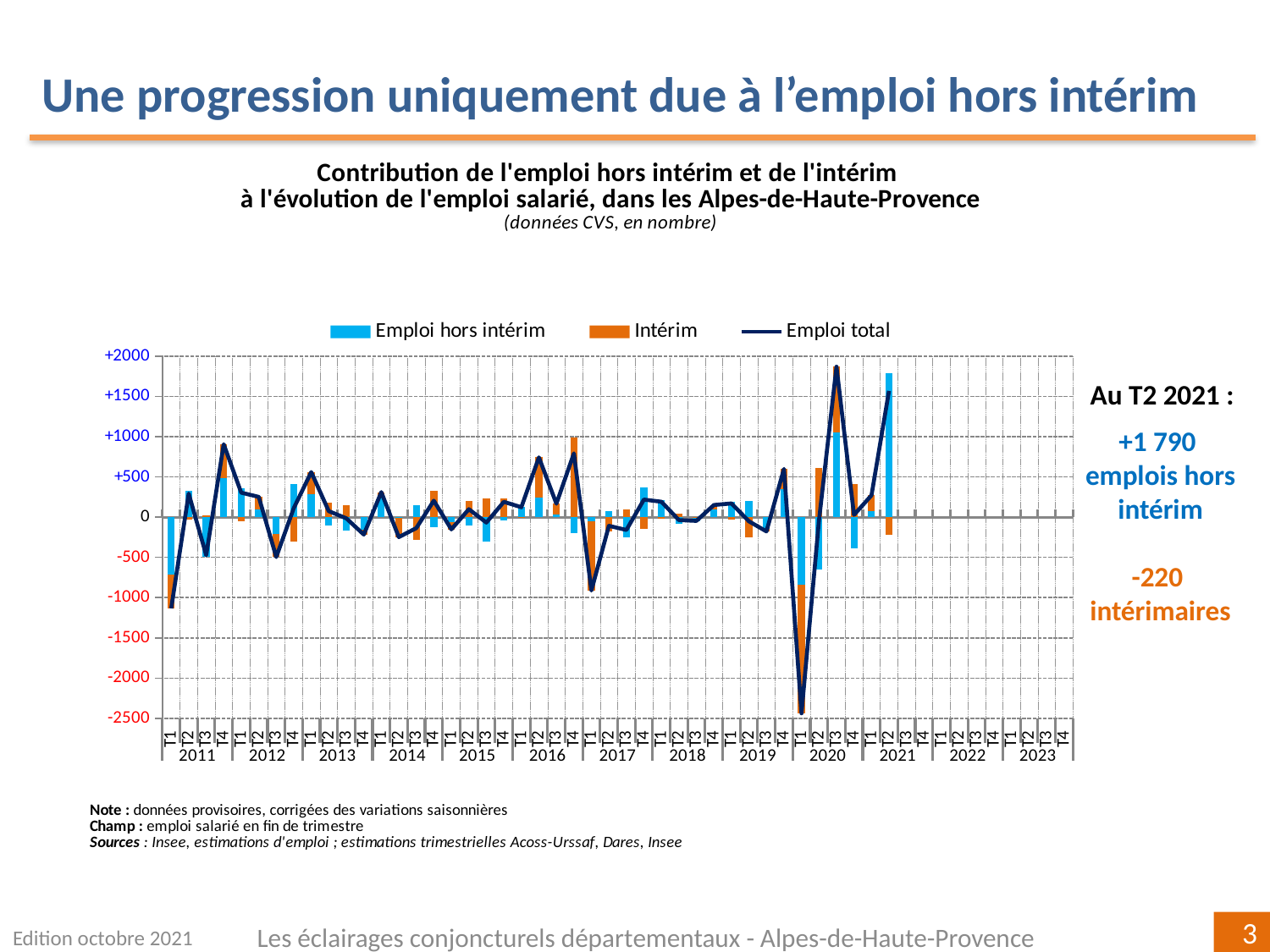
Is the value of Emploi total at T3 2020 greater or less than +1500? greater Is the value of Intérim at T1 2020 greater or less than -500? less At T2 2021, which is larger: the Emploi hors intérim value or the Intérim value? Emploi hors intérim Which series is drawn as a line in the chart? Emploi total In which quarter does Emploi total reach its lowest value? T1 2020 In which quarter does Emploi total reach its highest value? T3 2020 What kind of chart is shown on the slide? bar and line chart How many years are labelled along the x axis of the chart? 13 How many series does the chart legend list? 3 Is the value of Emploi total at T1 2020 greater or less than -2000? less What is the value of Emploi hors intérim at T2 2021? +1 790 What is the value of Intérim at T2 2021? -220